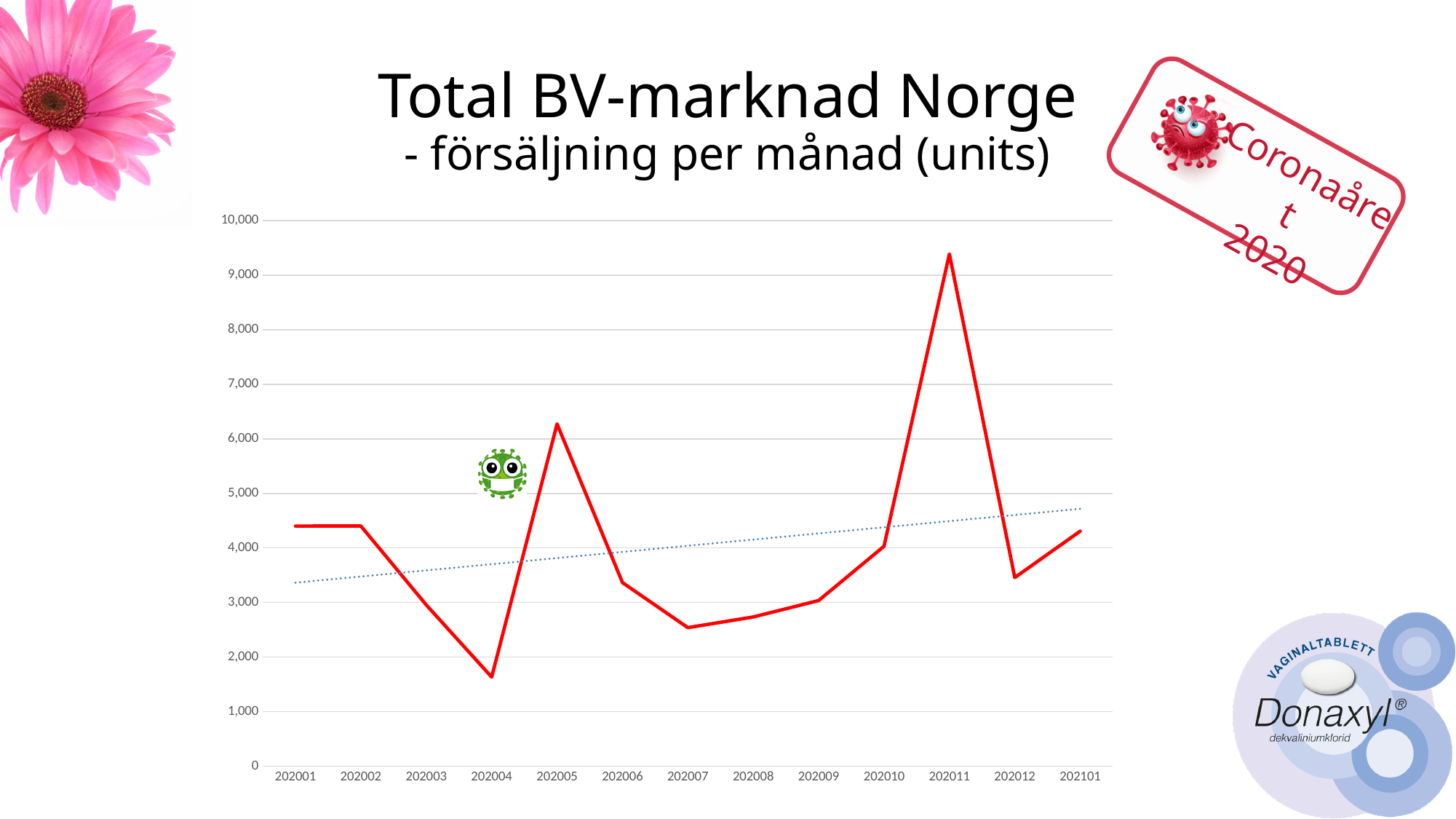
Which month has the lowest sales value? 202004 What is the main title of the chart on the slide? Total BV-marknad Norge Which is larger, the value for 202005 or the value for 202010? 202005 What kind of chart is shown on the slide? line chart How many months (data points) are plotted along the x axis? 13 Do the values rise or fall from 202001 to 202004? fall Is the value for 202011 greater or less than 9,000? greater Is the value for 202007 greater or less than 3,000? less Is the value for 202005 greater or less than 6,000? greater Do the values rise or fall from 202007 to 202011? rise Which month has the highest sales value? 202011